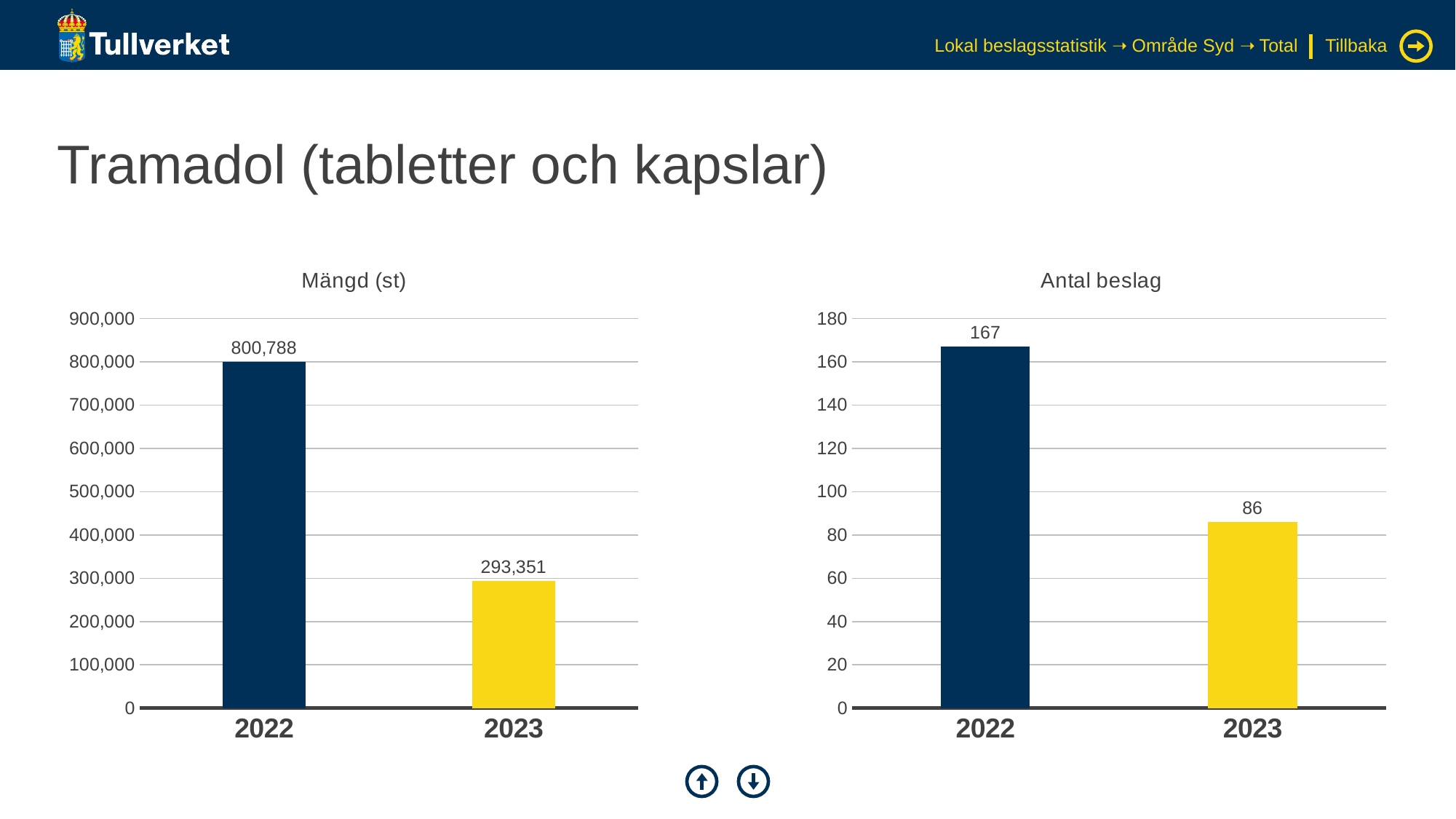
In the 'Antal beslag' chart, what is the difference between the 2022 and 2023 values? 81 In the 'Mängd (st)' chart, what is the difference between the 2022 and 2023 values? 507,437 In the 'Antal beslag' chart, what is the value for 2023? 86 In the 'Mängd (st)' chart, is the value for 2023 greater or less than 400,000? less In the 'Mängd (st)' chart, which year has the highest value? 2022 What kind of chart is the 'Mängd (st)' chart? Bar chart In the 'Antal beslag' chart, which year has the lowest value? 2023 In the 'Antal beslag' chart, is the value for 2022 larger than the value for 2023? Yes In the 'Mängd (st)' chart, what is the value for 2023? 293,351 How many categories are shown on the x axis of the 'Antal beslag' chart? 2 In the 'Antal beslag' chart, what is the value for 2022? 167 In the 'Mängd (st)' chart, what is the value for 2022? 800,788